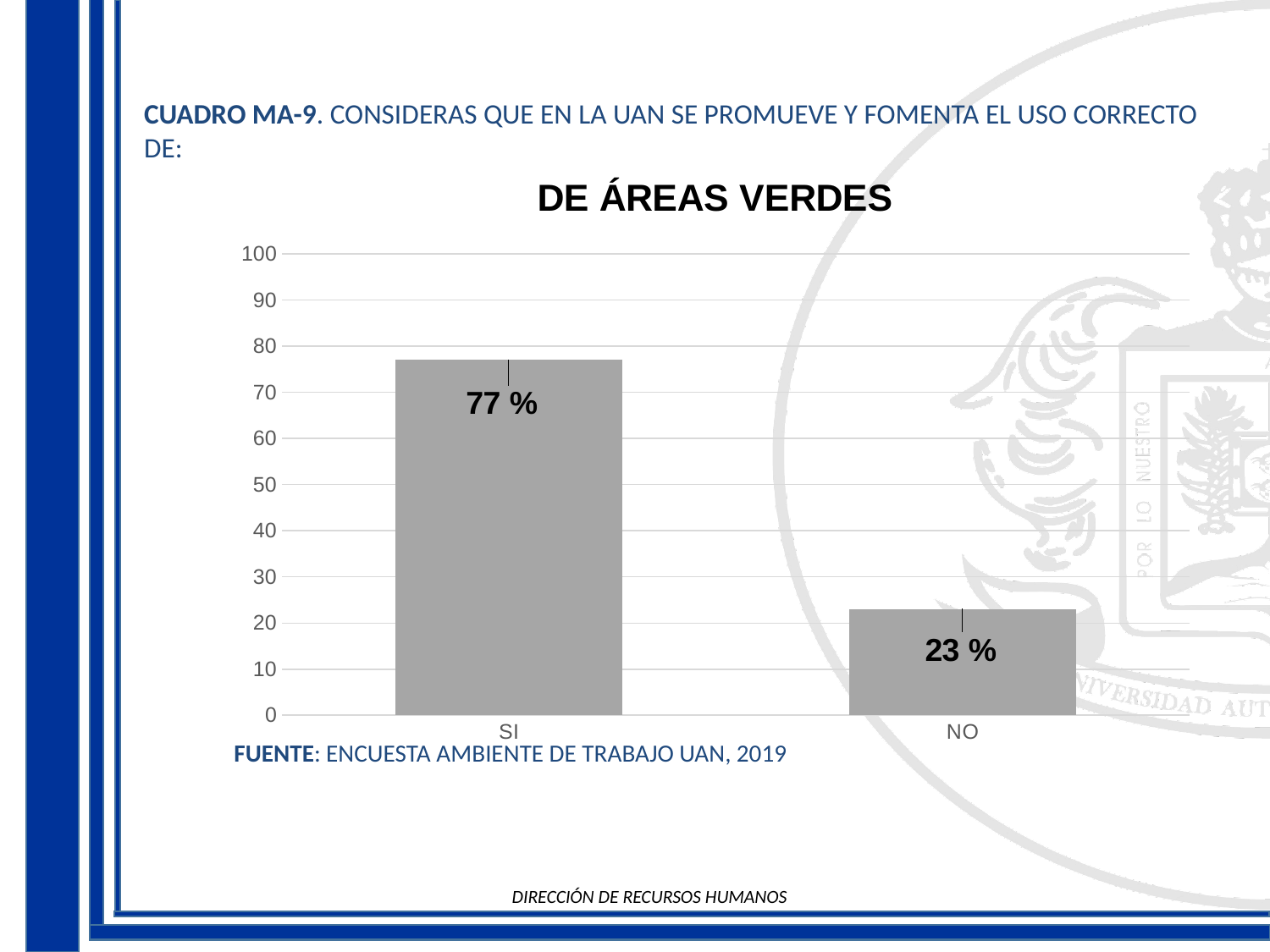
Is the value for NO greater or less than 30? less Which category has the lowest value? NO Is the value for SI greater or less than 70? greater What is the difference between the values for SI and NO? 54 % What is the title of the chart? DE ÁREAS VERDES What is the value for SI? 77 % What is the value for NO? 23 % Which category has the highest value? SI What kind of chart is shown? bar chart What is the maximum value shown on the y axis? 100 Which is larger, the value for SI or the value for NO? SI How many categories are shown on the x axis? 2